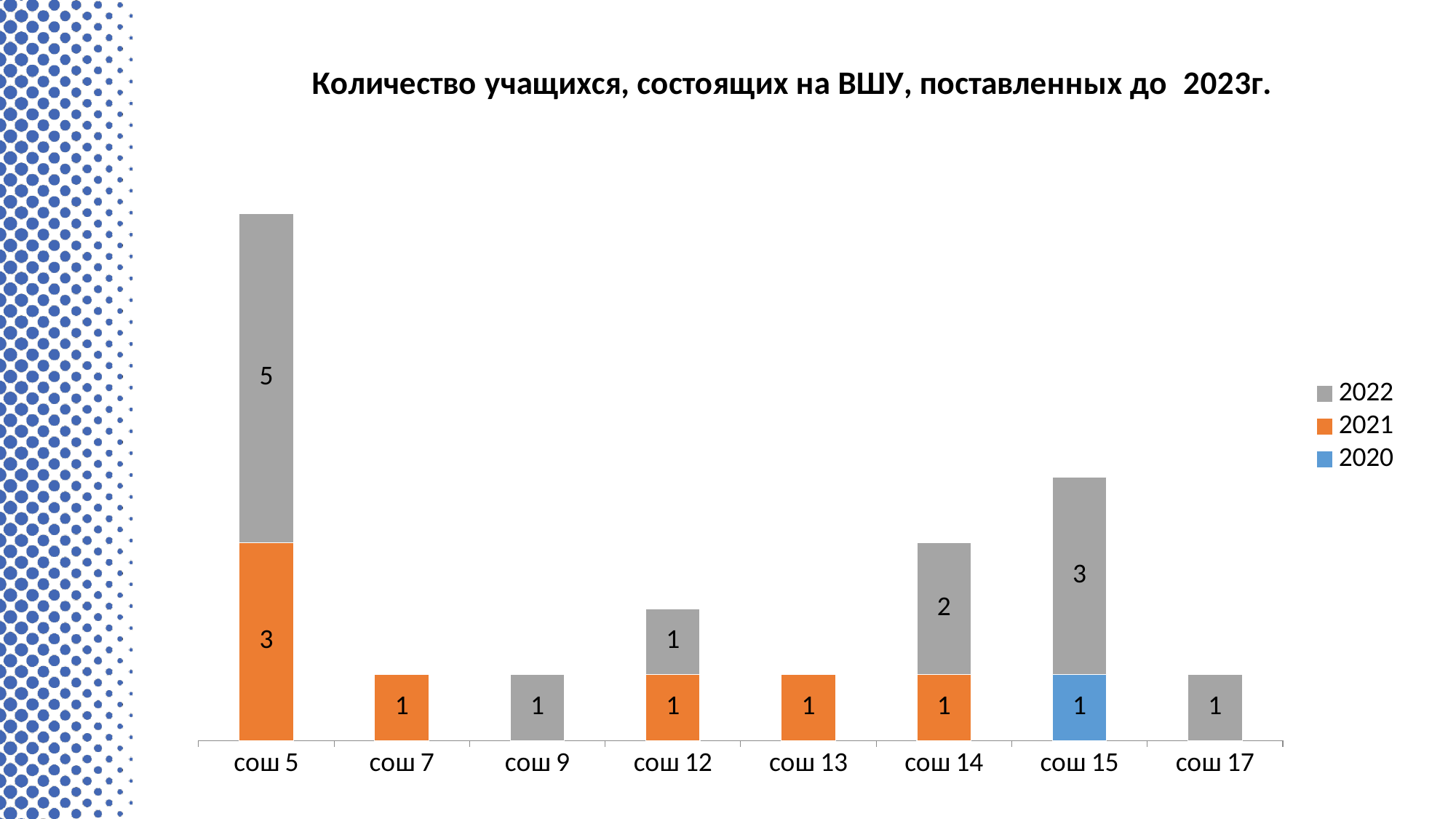
What is the 2020 value for сош 15? 1 Which is larger, the 2022 value for сош 14 or the 2022 value for сош 15? сош 15 What is the 2022 value for сош 5? 5 What is the total of the stacked bar for сош 5? 8 What is the 2022 value for сош 14? 2 What is the difference between the 2022 values for сош 5 and сош 15? 2 Which school has the highest total number of students? сош 5 How many schools (categories) are shown on the x axis? 8 What is the total of the stacked bar for сош 15? 4 How many series does the legend list? 3 What type of chart is shown on the slide? stacked bar chart What is the 2021 value for сош 5? 3